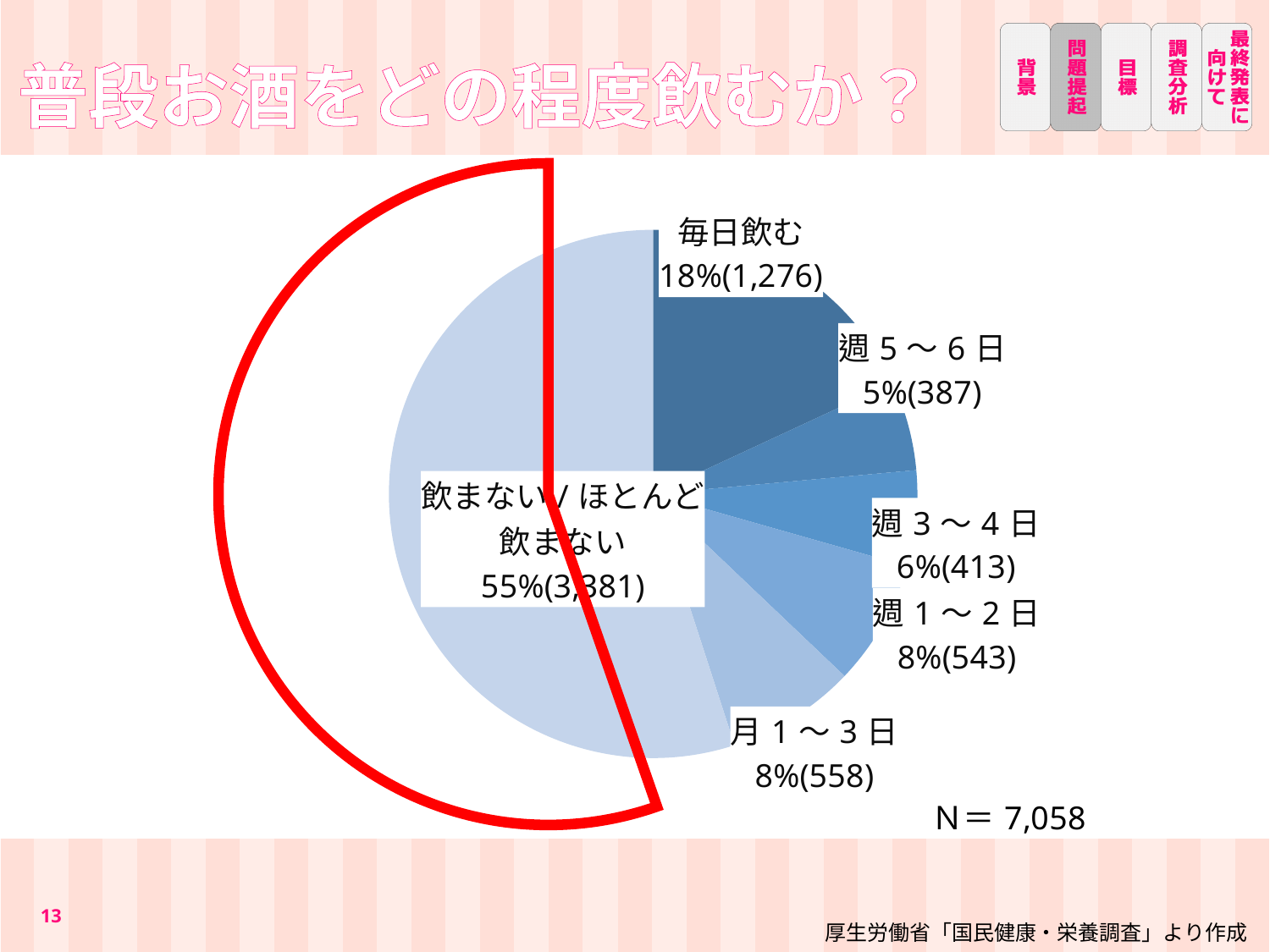
What kind of chart is shown on the slide? Pie chart What percentage of respondents answered 毎日飲む? 18% What is the difference in respondent counts between 毎日飲む and 週5～6日? 889 What is the total sample size N shown on the slide? 7,058 How many categories are shown in the pie chart? 6 What is the difference in percentage points between 飲まない/ほとんど飲まない and 毎日飲む? 37% Which category has the smallest share of the pie? 週5～6日 What is the number of respondents for 週3～4日? 413 What share of the pie does 週1～2日 represent? 8% How many respondents answered 飲まない/ほとんど飲まない? 3,881 Which has more respondents, 週1～2日 or 月1～3日? 月1～3日 Which category has the largest share of the pie? 飲まない/ほとんど飲まない